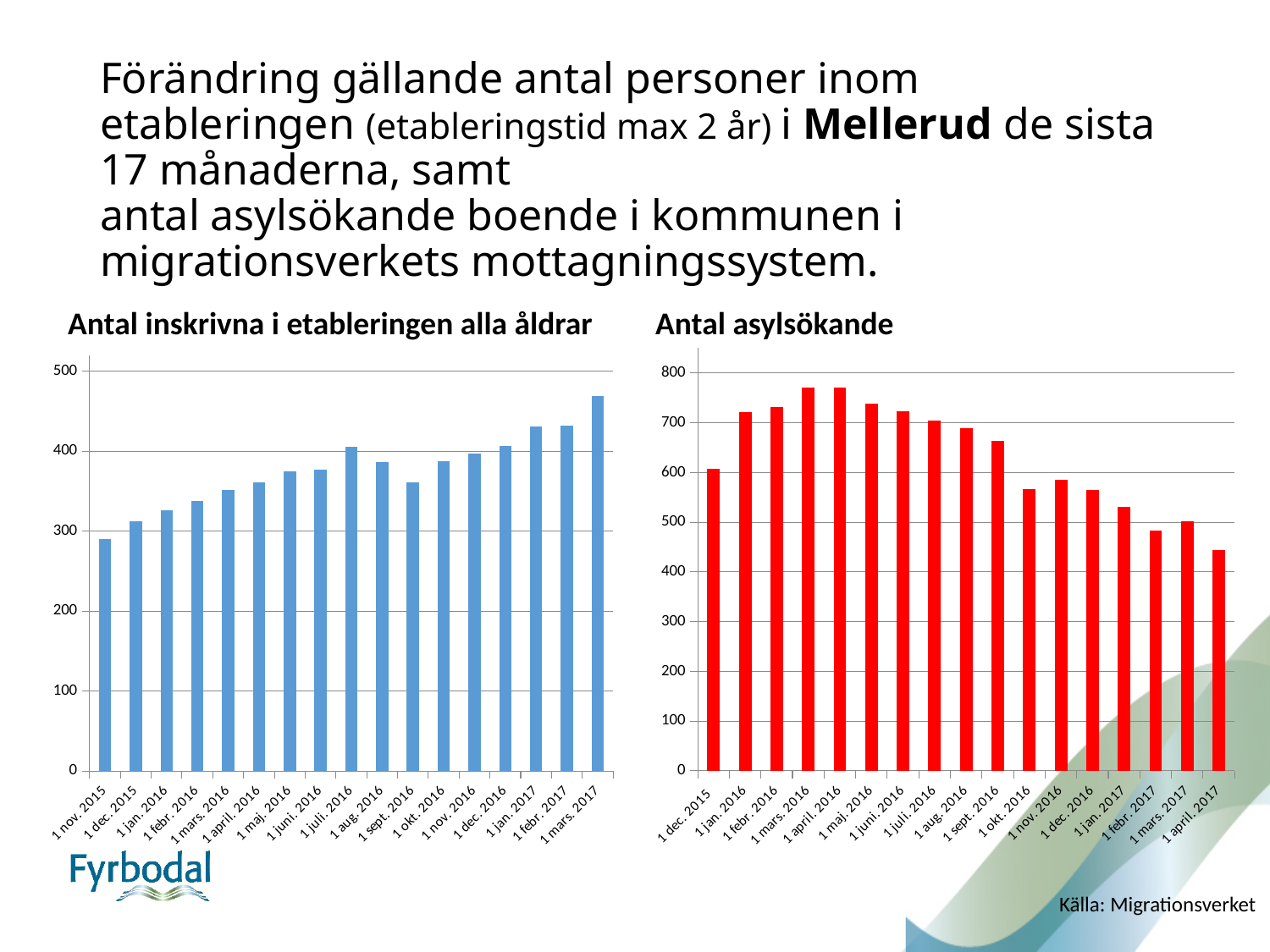
In the left chart "Antal inskrivna i etableringen alla åldrar", which is larger: the value for 1 juli 2016 or for 1 sept. 2016? 1 juli 2016 How many bars (months) are plotted in the left chart "Antal inskrivna i etableringen alla åldrar"? 17 How many bars (months) are plotted in the right chart "Antal asylsökande"? 17 In the right chart "Antal asylsökande", is the value for 1 jan. 2016 greater or less than 700? greater In the right chart "Antal asylsökande", which month has the lowest value? 1 april 2017 What colour are the bars in the right chart "Antal asylsökande"? red In the left chart "Antal inskrivna i etableringen alla åldrar", which month has the lowest value? 1 nov. 2015 In the right chart "Antal asylsökande", is the value for 1 april 2017 greater or less than 500? less In the right chart "Antal asylsökande", do the values generally rise or fall from 1 april 2016 to 1 april 2017? fall In the left chart "Antal inskrivna i etableringen alla åldrar", is the value for 1 nov. 2015 greater or less than 300? less What kind of chart is the left chart titled "Antal inskrivna i etableringen alla åldrar"? bar chart In the left chart "Antal inskrivna i etableringen alla åldrar", which month has the highest value? 1 mars 2017